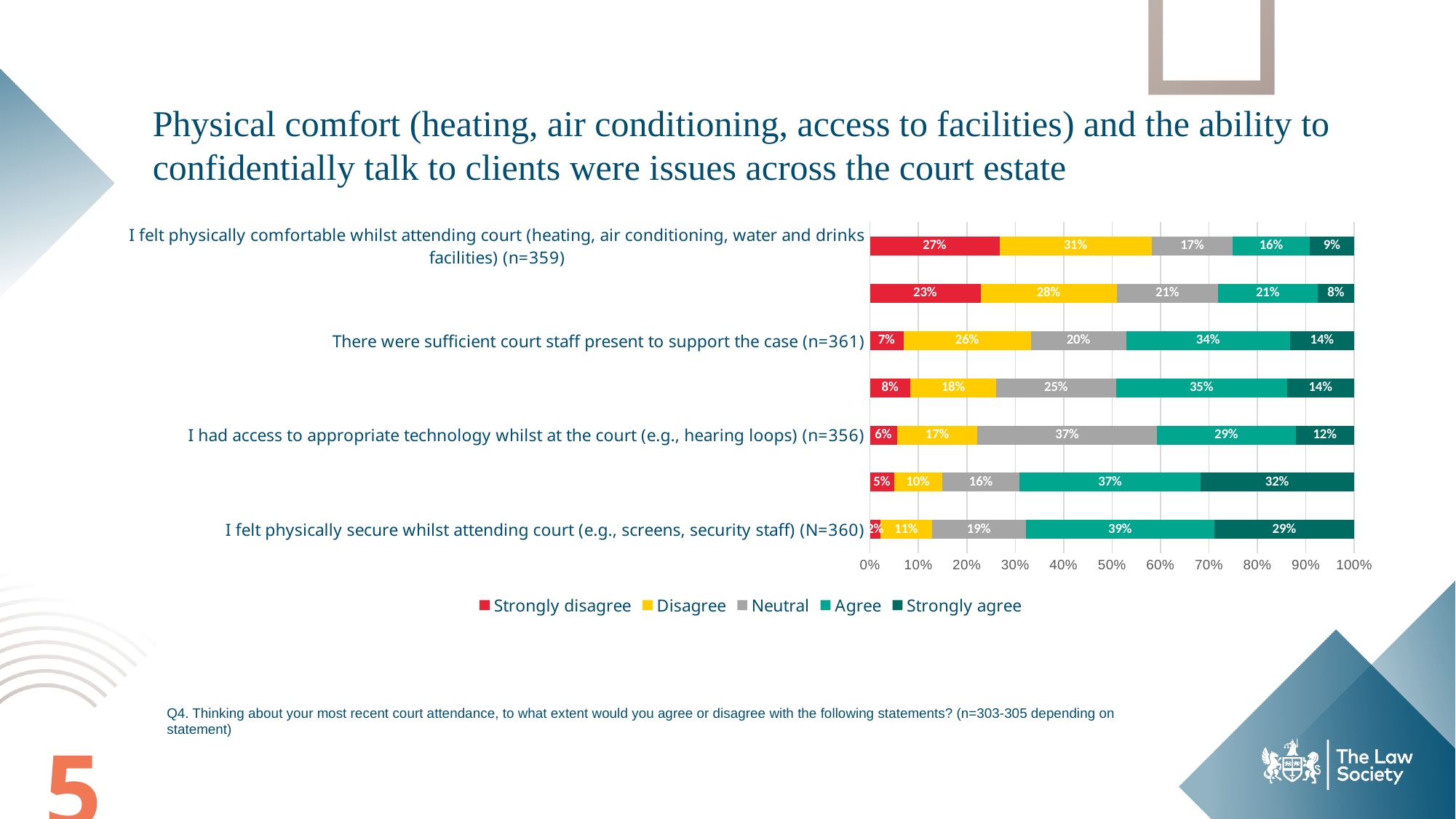
What is the difference between the Agree percentage for 'I felt physically secure whilst attending court' and the Agree percentage for 'I felt physically comfortable whilst attending court'? 23 percentage points What is the Neutral percentage for the statement 'I had access to appropriate technology whilst at the court'? 37% Which is larger: the Neutral share for 'I had access to appropriate technology' or the Neutral share for 'There were sufficient court staff present'? I had access to appropriate technology What percentage of respondents agreed that there were sufficient court staff present to support the case? 34% What kind of chart is shown on the slide? Stacked bar chart Among the labelled statements, which has the highest Strongly disagree percentage? I felt physically comfortable whilst attending court (heating, air conditioning, water and drinks facilities) What percentage of respondents strongly disagreed that they felt physically comfortable whilst attending court? 27% What percentage strongly agreed that they felt physically secure whilst attending court? 29% What is the Disagree percentage for the statement 'I felt physically comfortable whilst attending court'? 31% Among the labelled statements, which has the lowest Strongly agree percentage? I felt physically comfortable whilst attending court (heating, air conditioning, water and drinks facilities) How many series does the legend list? 5 Which colour represents 'Strongly agree' in the chart? Dark green